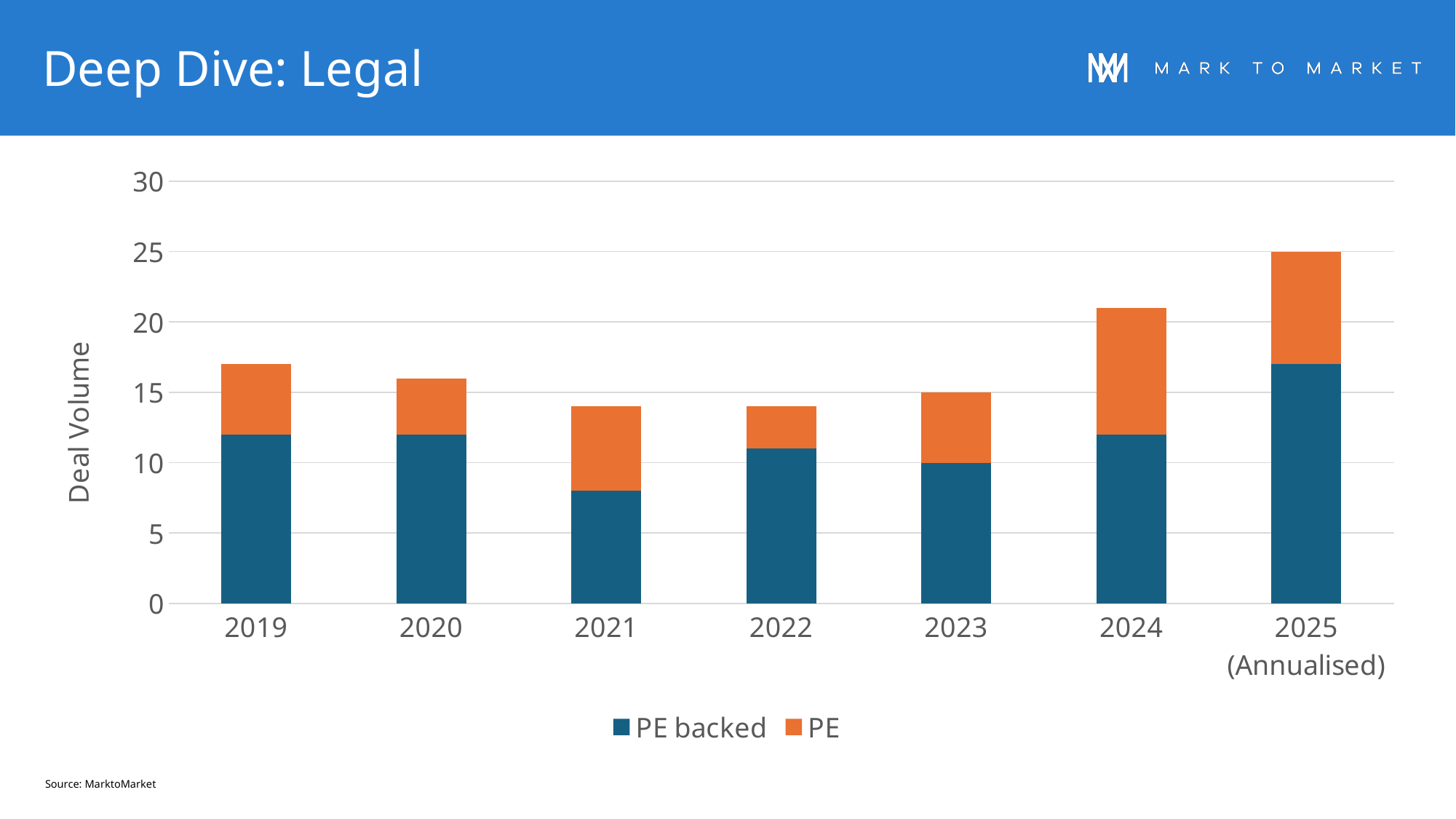
How many series does the legend list? 2 How many years (categories) are shown on the x axis? 7 Is the PE backed deal volume for 2021 greater or less than 10? less Which year has the highest total deal volume? 2025 (Annualised) What is the label of the y axis? Deal Volume What is the total deal volume for 2025 (Annualised)? 25 Which is larger, the total deal volume for 2019 or for 2021? 2019 What kind of chart is shown on the slide? stacked bar chart What is the total deal volume for 2023? 15 Does the total deal volume rise or fall from 2023 to 2025 (Annualised)? rise What is the PE backed deal volume for 2023? 10 Is the total deal volume for 2024 greater or less than 20? greater